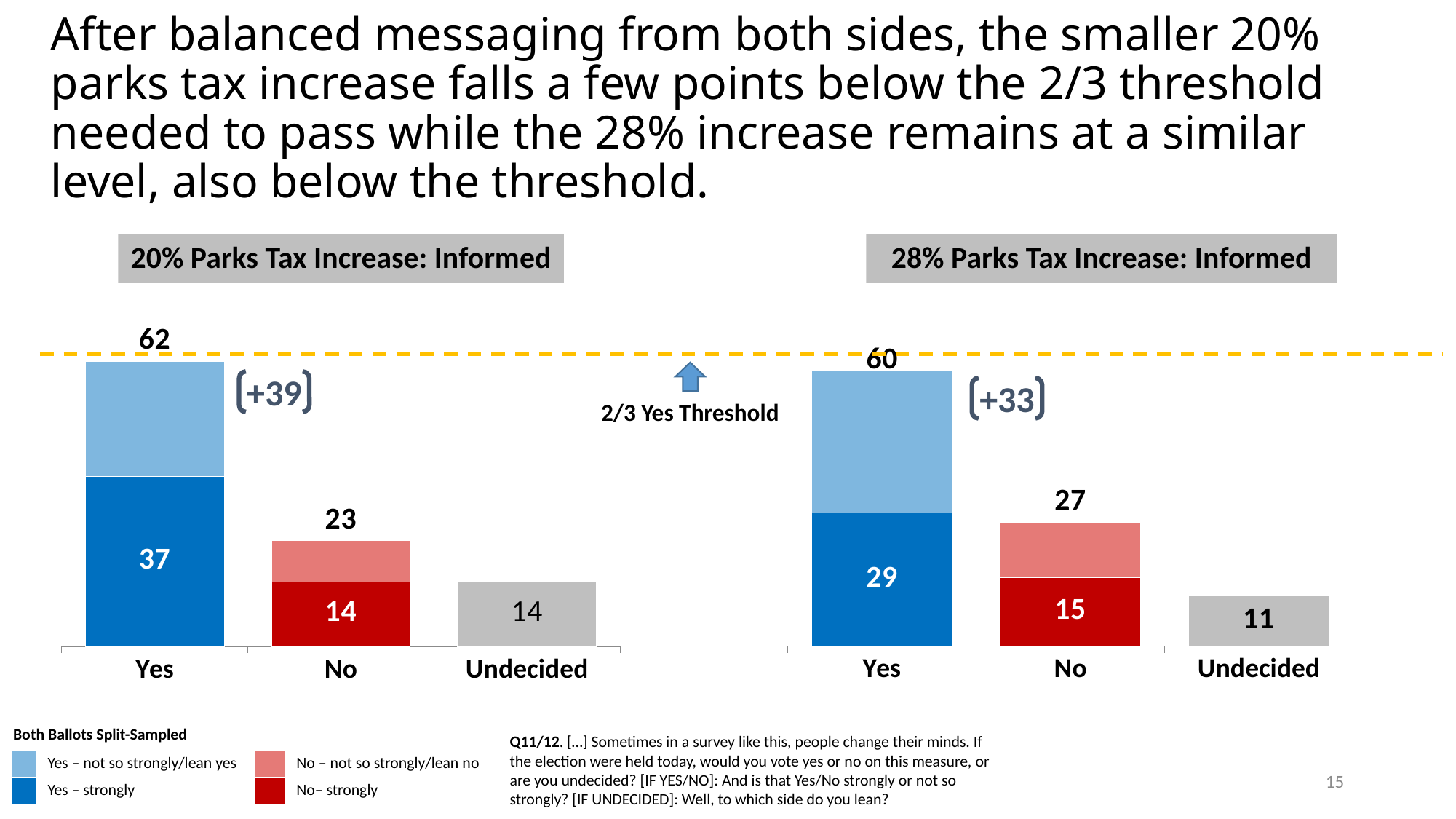
In the 20% Parks Tax Increase: Informed chart, what is the value for Yes – strongly? 37 How many entries does the legend at the bottom of the slide list? 4 In the 28% Parks Tax Increase: Informed chart, what is the value for Undecided? 11 In the 20% Parks Tax Increase: Informed chart, what is the difference between the Yes total and the No total? 39 In the 28% Parks Tax Increase: Informed chart, what is the value for No – strongly? 15 In the 28% Parks Tax Increase: Informed chart, what is the total value of the Yes bar? 60 How many categories are shown on the x axis of the 20% Parks Tax Increase: Informed chart? 3 In the 20% Parks Tax Increase: Informed chart, what is the total value of the Yes bar? 62 In the 28% Parks Tax Increase: Informed chart, what is the difference between the Yes total and the No total? 33 In the 20% Parks Tax Increase: Informed chart, which category has the lowest total? Undecided In the 28% Parks Tax Increase: Informed chart, which category has the highest total? Yes Which chart has the larger No total, the 20% Parks Tax Increase chart or the 28% Parks Tax Increase chart? 28% Parks Tax Increase